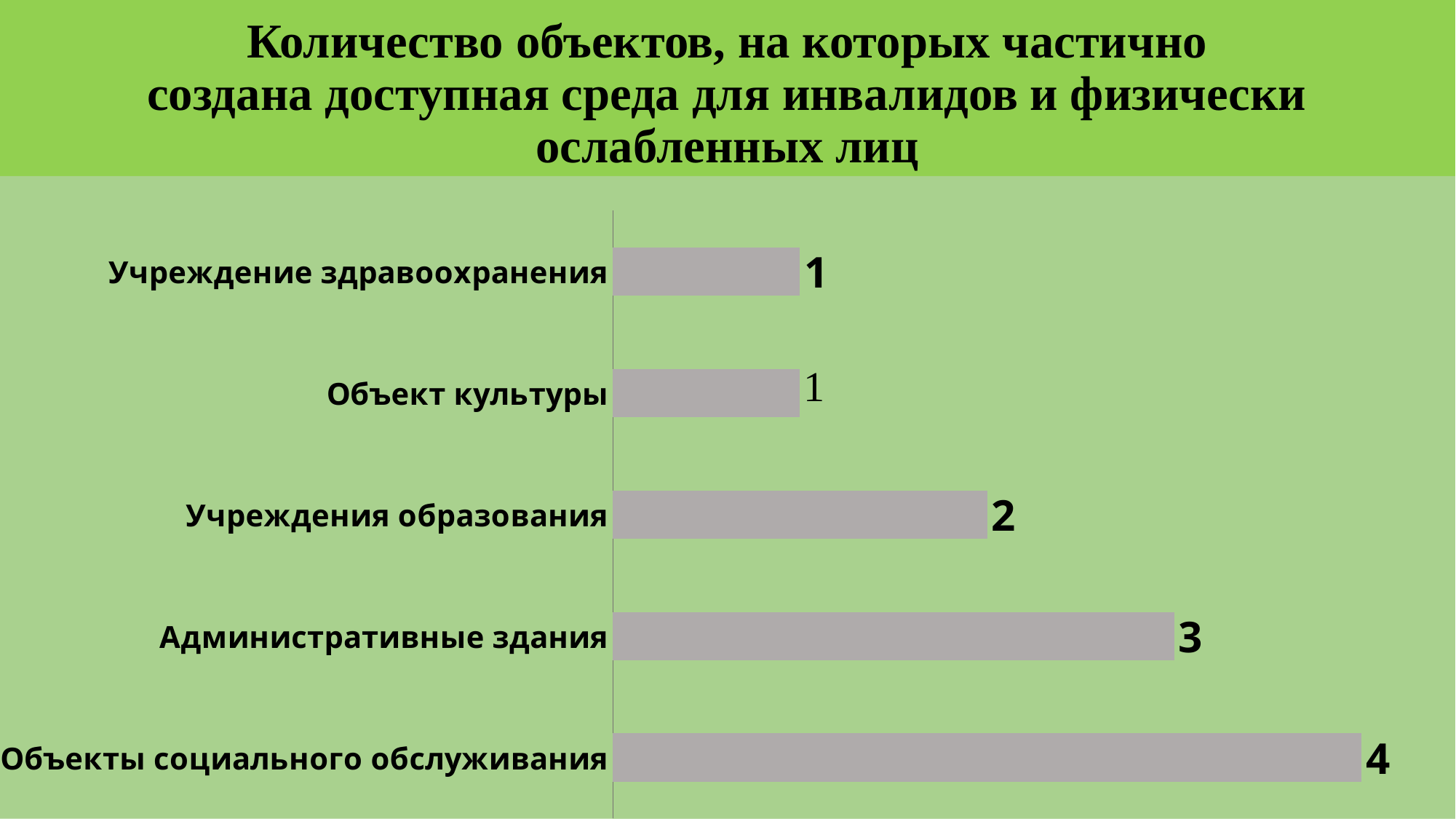
What is the difference between the values for Объекты социального обслуживания and Учреждения образования? 2 How many categories are shown in the chart? 5 What is the title of the chart? Количество объектов, на которых частично создана доступная среда для инвалидов и физически ослабленных лиц Do the values rise or fall going from the top bar to the bottom bar? rise What is the difference between the values for Административные здания and Учреждение здравоохранения? 2 Which is larger, the value for Административные здания or the value for Объект культуры? Административные здания What is the value for Административные здания? 3 What is the value for Учреждения образования? 2 What type of chart is shown on the slide? bar chart What is the value for Учреждение здравоохранения? 1 What is the value for Объекты социального обслуживания? 4 Which category has the highest value? Объекты социального обслуживания